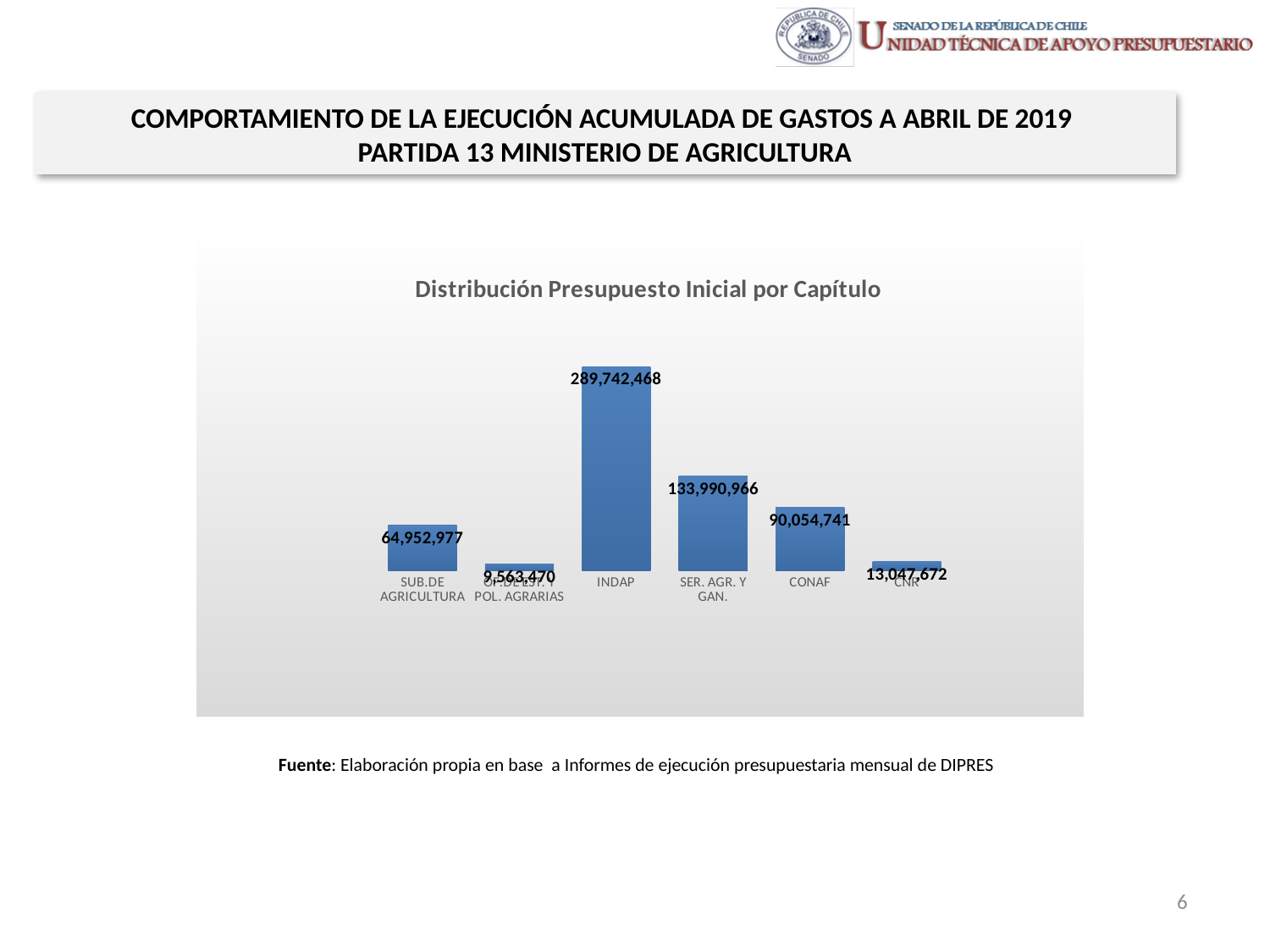
What is the difference between the values for CONAF and SUB.DE AGRICULTURA? 25,101,764 What type of chart is shown on the slide? Bar chart Which category has the lowest value in the chart? OF.DE EST. Y POL. AGRARIAS How many categories are shown in the chart? 6 What is the value for SUB.DE AGRICULTURA in the chart? 64,952,977 What is the value for SER. AGR. Y GAN. in the chart? 133,990,966 What is the value for CNR in the chart? 13,047,672 Which is larger, the value for CONAF or the value for SUB.DE AGRICULTURA? CONAF Which category has the highest value in the chart? INDAP What is the difference between the values for INDAP and SER. AGR. Y GAN.? 155,751,502 What is the value for CONAF in the chart? 90,054,741 What is the value for INDAP in the chart? 289,742,468